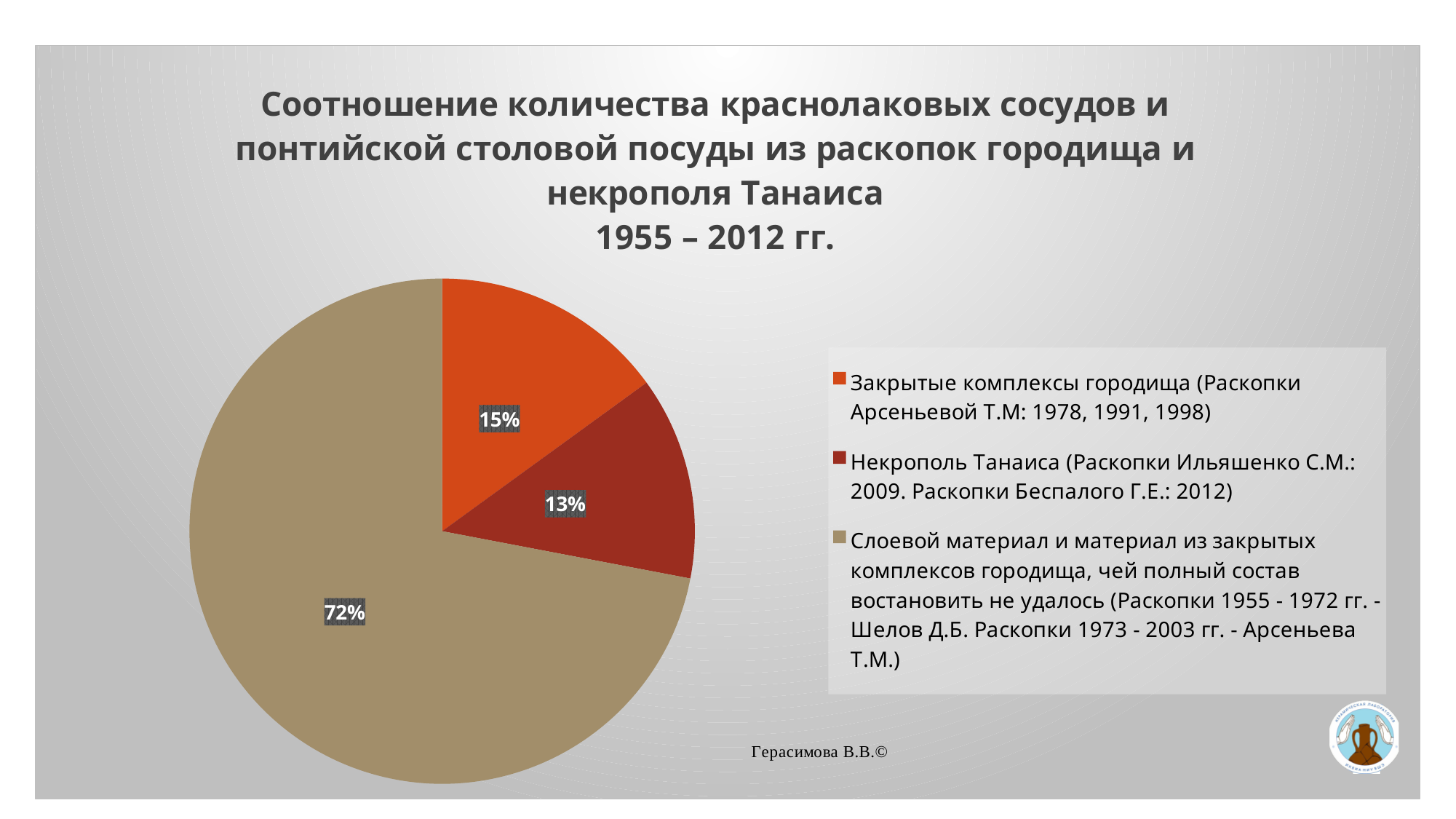
Which is larger: the slice for "Закрытые комплексы городища" or the slice for "Некрополь Танаиса"? Закрытые комплексы городища What years are given in the chart title? 1955 – 2012 гг. How many slices does the pie chart have? 3 What share of the pie is labelled for "Закрытые комплексы городища (Раскопки Арсеньевой Т.М: 1978, 1991, 1998)"? 15% What colour is the slice representing "Некрополь Танаиса"? dark red What kind of chart is shown on the slide? pie chart What is the difference in percentage points between the slice for "Закрытые комплексы городища" and the slice for "Некрополь Танаиса"? 2 What share of the pie is labelled for "Слоевой материал и материал из закрытых комплексов городища, чей полный состав востановить не удалось"? 72% Which category has the smallest slice of the pie? Некрополь Танаиса What share of the pie is labelled for "Некрополь Танаиса (Раскопки Ильяшенко С.М.: 2009. Раскопки Беспалого Г.Е.: 2012)"? 13% Which category has the largest slice of the pie? Слоевой материал и материал из закрытых комплексов городища, чей полный состав востановить не удалось How many entries does the legend list? 3